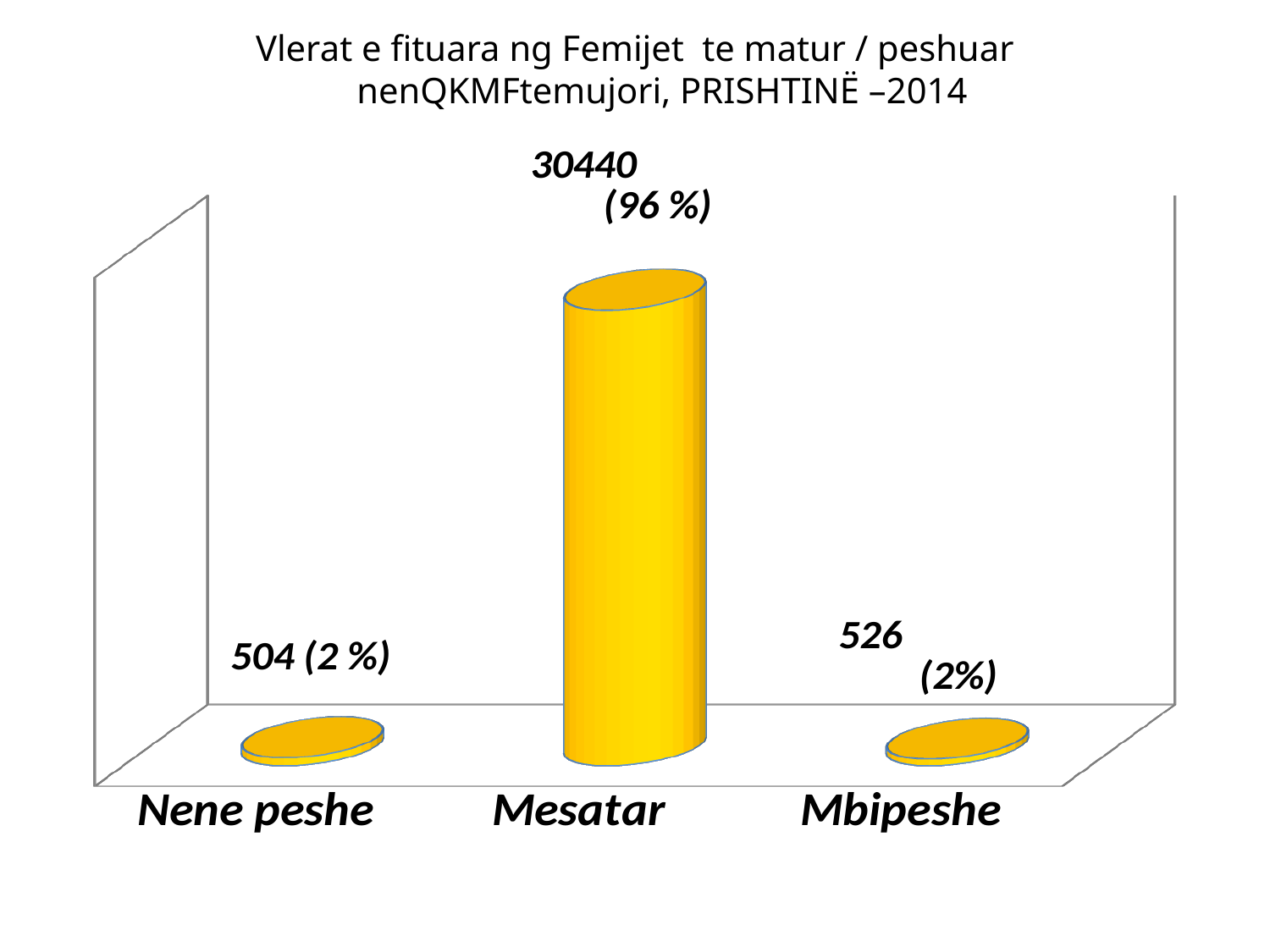
What value is shown for the Mbipeshe category? 526 How many categories are shown on the chart? 3 What year is mentioned in the chart title? 2014 What percentage is shown next to the Mesatar bar? 96 % Which is larger, the value for Mbipeshe or the value for Nene peshe? Mbipeshe What value is shown for the Mesatar category? 30440 What is the difference between the values for Mbipeshe and Nene peshe? 22 What is the difference between the values for Mesatar and Nene peshe? 29936 What value is shown for the Nene peshe category? 504 Which category has the highest value? Mesatar What kind of chart is shown on the slide? Bar chart Which category has the lowest value? Nene peshe